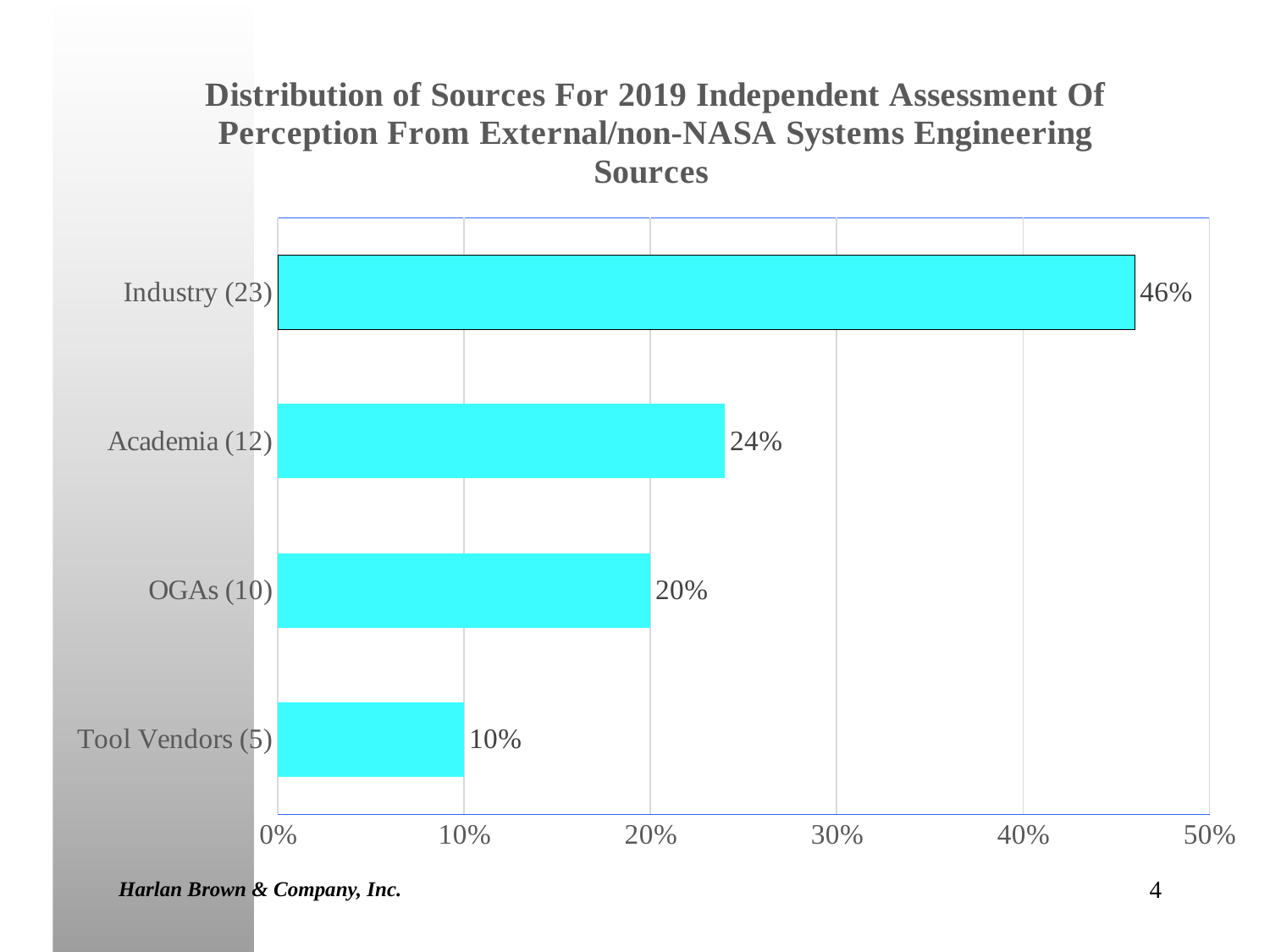
Which category has the highest value? Industry (23) How many categories are shown in the chart? 4 Is the value for Industry (23) greater or less than 40%? greater Which is larger, the value for Academia (12) or the value for OGAs (10)? Academia (12) What kind of chart is shown on the slide? Bar chart What is the value for Industry (23)? 46% What is the value for OGAs (10)? 20% What is the difference between the values for Industry (23) and Academia (12)? 22% What is the difference between the values for OGAs (10) and Tool Vendors (5)? 10% Which category has the lowest value? Tool Vendors (5) What is the value for Academia (12)? 24% What is the value for Tool Vendors (5)? 10%